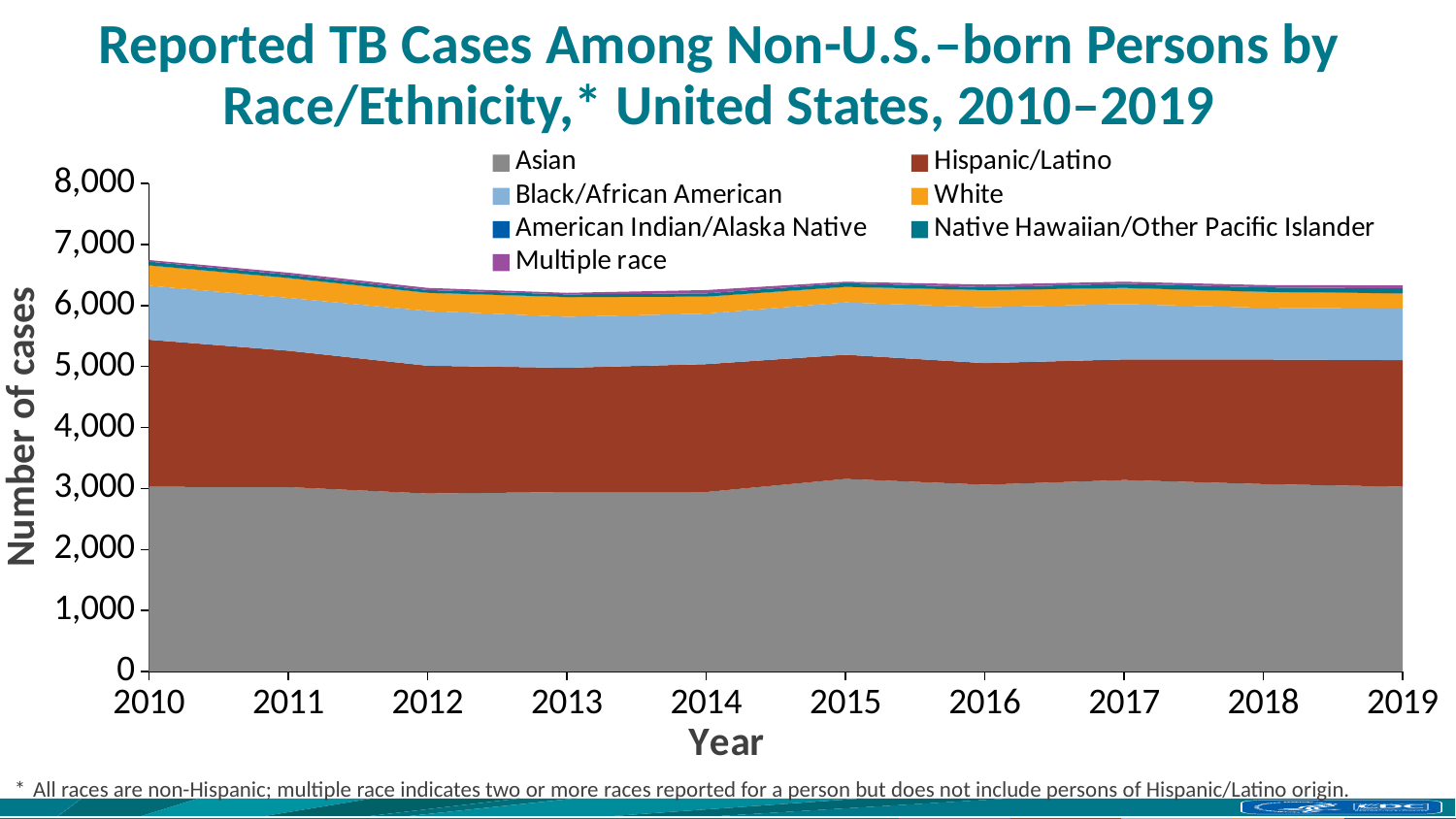
How many years are plotted along the x axis? 10 How many series does the legend list? 7 What is the title of the chart? Reported TB Cases Among Non-U.S.–born Persons by Race/Ethnicity,* United States, 2010–2019 Is the total number of cases in 2019 greater or less than 6,000? greater Which race/ethnicity group accounts for the largest number of cases in every year? Asian What is the label of the y axis? Number of cases Which group has more reported cases in 2019, Asian or White? Asian What kind of chart is shown on the slide? Stacked area chart Is the number of Asian cases in 2010 greater or less than 2,000? greater Does the total number of cases rise or fall from 2010 to 2012? fall Is the number of Asian cases in 2012 greater or less than 4,000? less